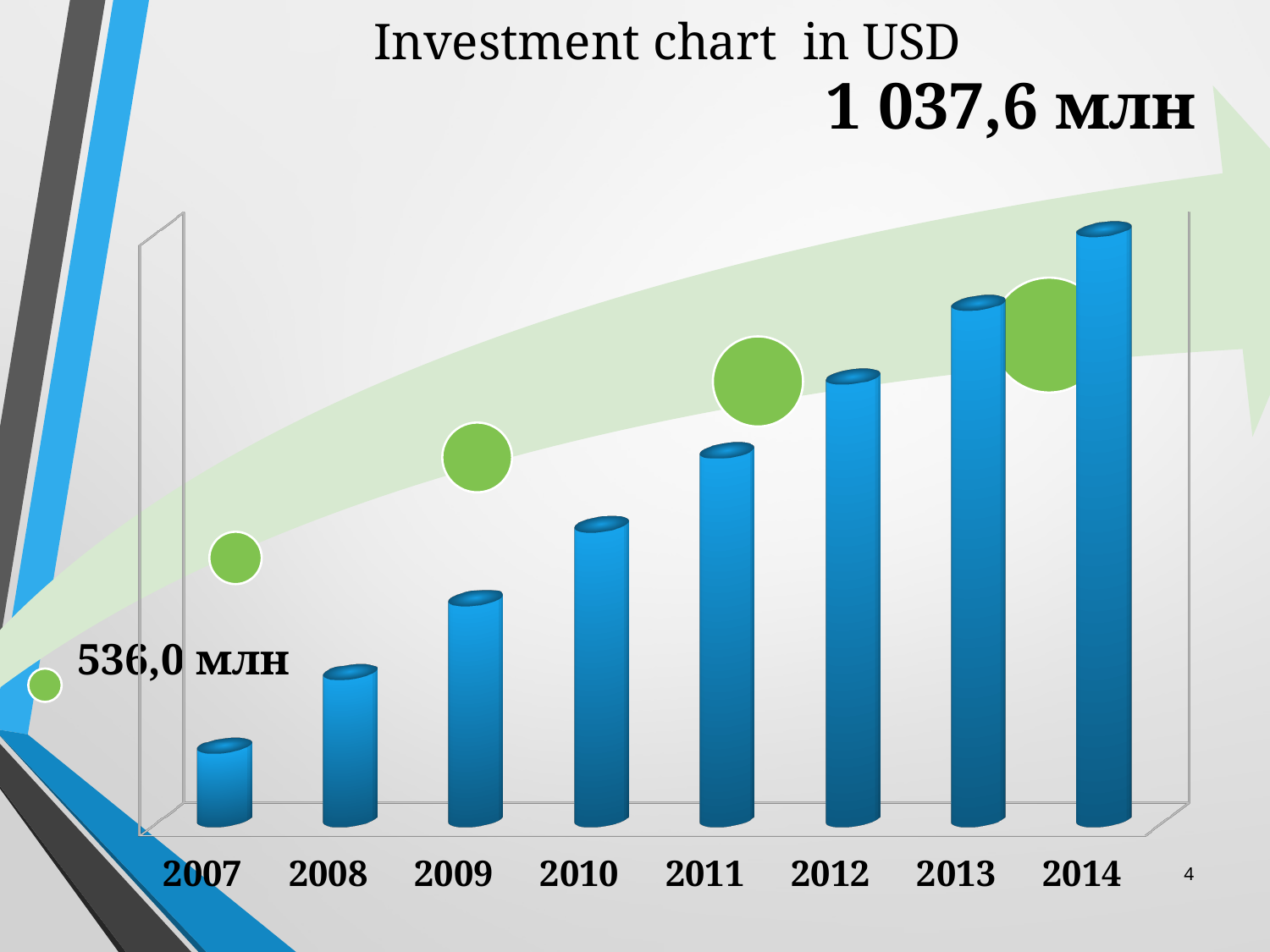
Which year has the larger bar, 2009 or 2008? 2009 Which year has the larger bar, 2010 or 2012? 2012 Which year has the highest bar in the chart? 2014 Which year has the lowest bar in the chart? 2007 What kind of chart is shown on the slide? bar chart Do the bar values rise or fall from 2007 to 2014? rise Which year has the larger bar, 2013 or 2011? 2013 What is the first year shown on the x axis of the chart? 2007 What is the title of the chart? Investment chart in USD How many years are shown on the x axis of the chart? 8